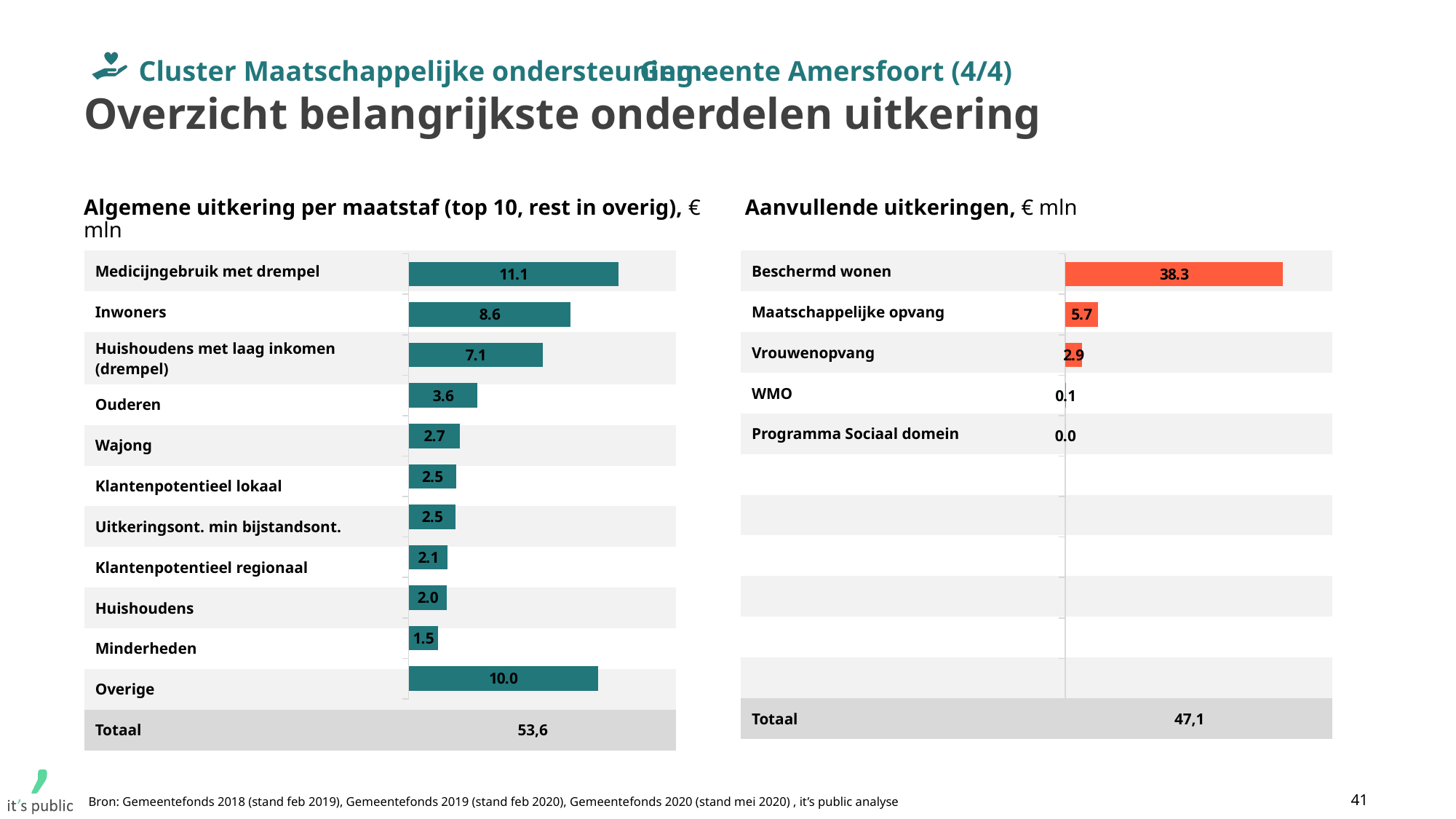
In the 'Algemene uitkering per maatstaf' chart, which is larger: Wajong or Klantenpotentieel regionaal? Wajong In the 'Aanvullende uitkeringen' chart, which category has the highest value? Beschermd wonen In the 'Algemene uitkering per maatstaf' chart, what is the value for Medicijngebruik met drempel? 11.1 In the 'Aanvullende uitkeringen' chart, what is the difference between Beschermd wonen and Vrouwenopvang? 35.4 What type of chart is the 'Aanvullende uitkeringen' chart? Bar chart In the 'Algemene uitkering per maatstaf' chart, which category has the lowest value? Minderheden In the 'Algemene uitkering per maatstaf' chart, what is the difference between Inwoners and Huishoudens met laag inkomen (drempel)? 1.5 In the 'Algemene uitkering per maatstaf' chart, what is the value for Ouderen? 3.6 In the 'Aanvullende uitkeringen' chart, what is the value for Maatschappelijke opvang? 5.7 How many categories (bars) are shown in the 'Aanvullende uitkeringen' chart? 5 How many categories (bars) are shown in the 'Algemene uitkering per maatstaf' chart, including Overige? 11 What is the Totaal shown for the 'Algemene uitkering per maatstaf' chart? 53,6